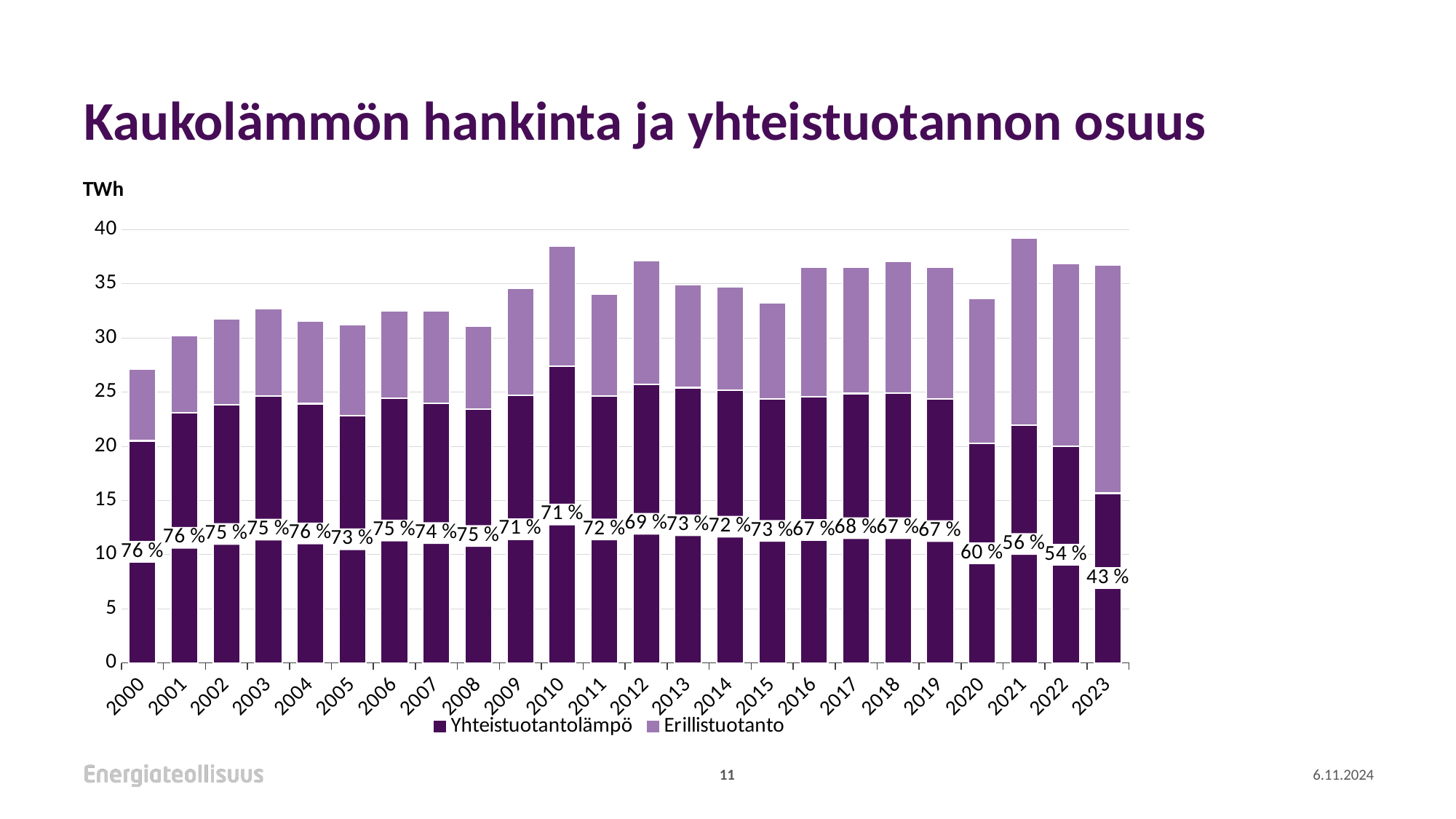
What is the difference in percentage points between the labels for 2000 and 2023? 33 How many years are shown on the x axis? 24 How many series does the legend list? 2 What percentage label is shown for 2023? 43 % What percentage label is shown for 2020? 60 % Is the total bar height for 2021 greater or less than 35 TWh? greater Which year has the larger percentage label, 2016 or 2017? 2017 Which year has the lowest percentage label? 2023 What kind of chart is shown on the slide? Stacked bar chart What percentage label is shown for 2012? 69 % Is the Yhteistuotantolämpö segment for 2010 greater or less than 25 TWh? greater Is the total bar height for 2000 greater or less than 30 TWh? less